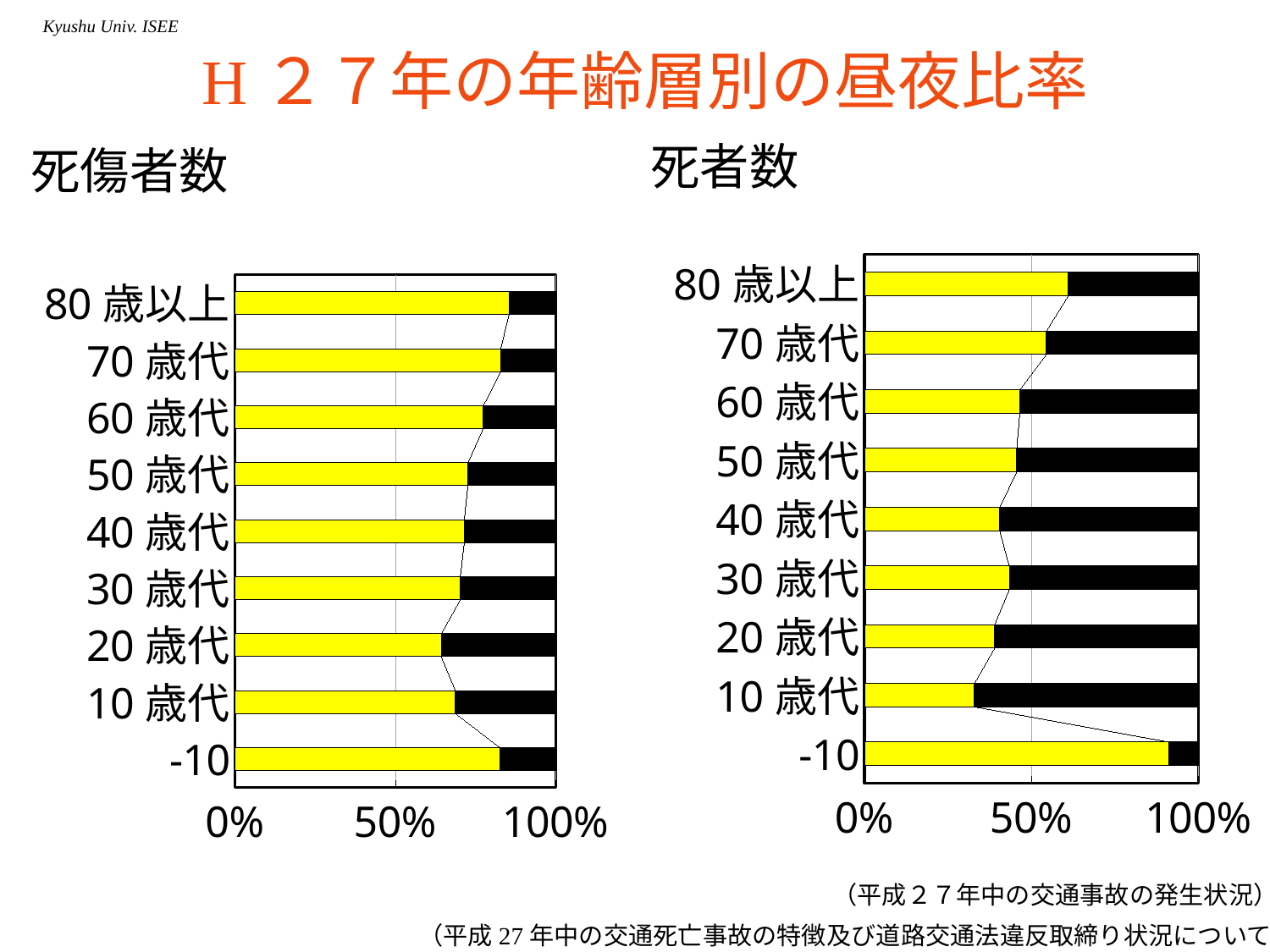
In the left chart (死傷者数), is the yellow portion for 20歳代 greater or less than 50%? greater In the right chart (死者数), is the yellow portion for 40歳代 greater or less than 50%? less What two colours are used for the bar segments in both charts? yellow and black How many age categories are shown on the right chart titled 死者数? 9 In the right chart (死者数), which has the larger yellow portion: 80歳以上 or 10歳代? 80歳以上 In the right chart (死者数), which age category has the smallest yellow portion? 10歳代 In the left chart (死傷者数), which age category has the smallest yellow portion? 20歳代 In the right chart (死者数), is the yellow portion for 10歳代 greater or less than 50%? less What kind of chart is the left chart titled 死傷者数? bar chart In the right chart (死者数), which age category has the largest yellow portion? -10